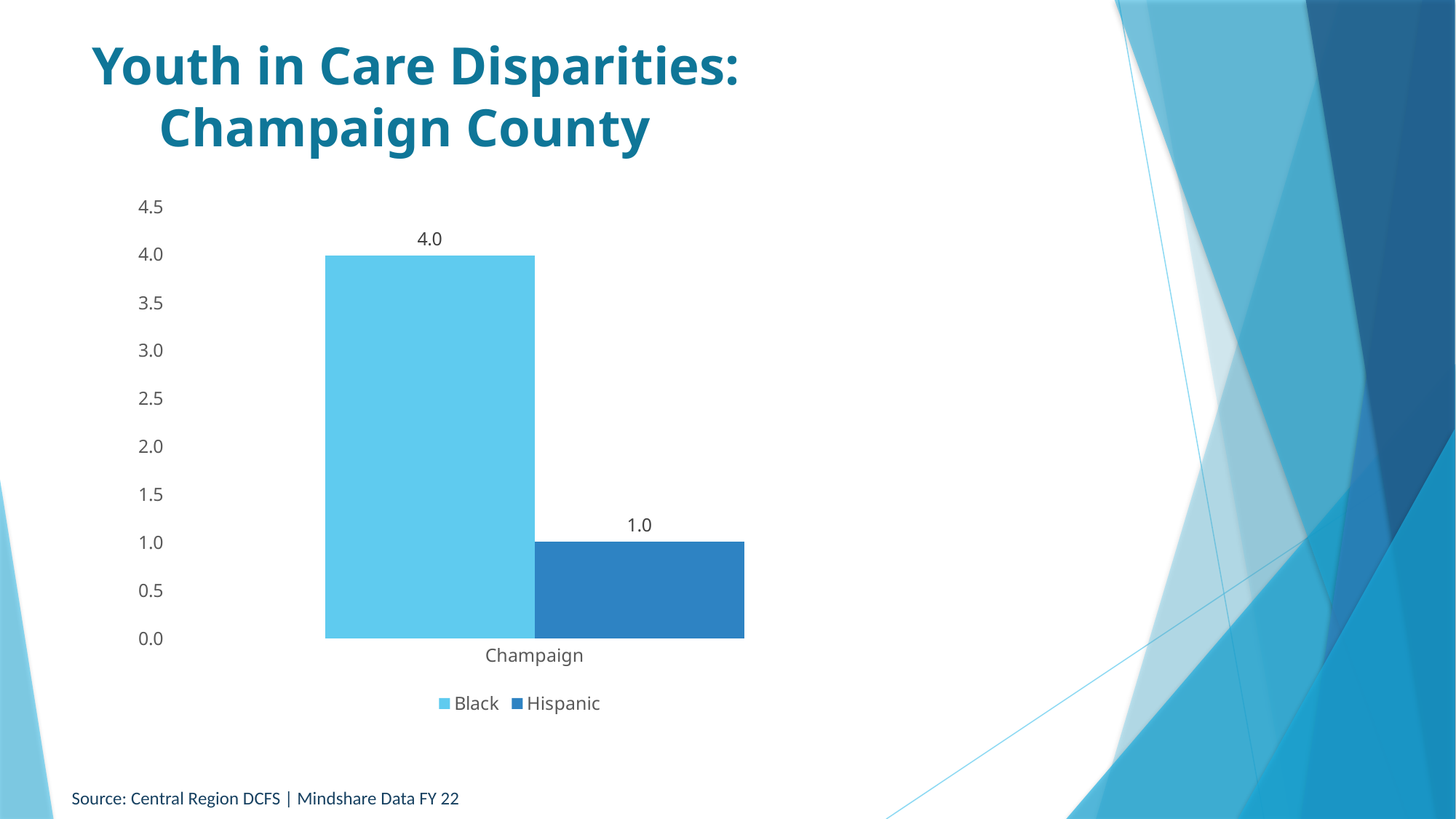
What is the value for Black in Champaign? 4.0 What kind of chart is shown on the slide? Bar chart Which series has the lowest value in the chart? Hispanic How many series does the legend list? 2 What is the difference between the Black and Hispanic values for Champaign? 3.0 How many categories are shown on the x axis? 1 What is the value for Hispanic in Champaign? 1.0 What is the highest value shown on the y axis? 4.5 Which series has the higher value for Champaign, Black or Hispanic? Black Is the value for Hispanic in Champaign greater or less than 2.0? less Is the value for Black in Champaign greater or less than 3.5? greater What is the title of the slide? Youth in Care Disparities: Champaign County